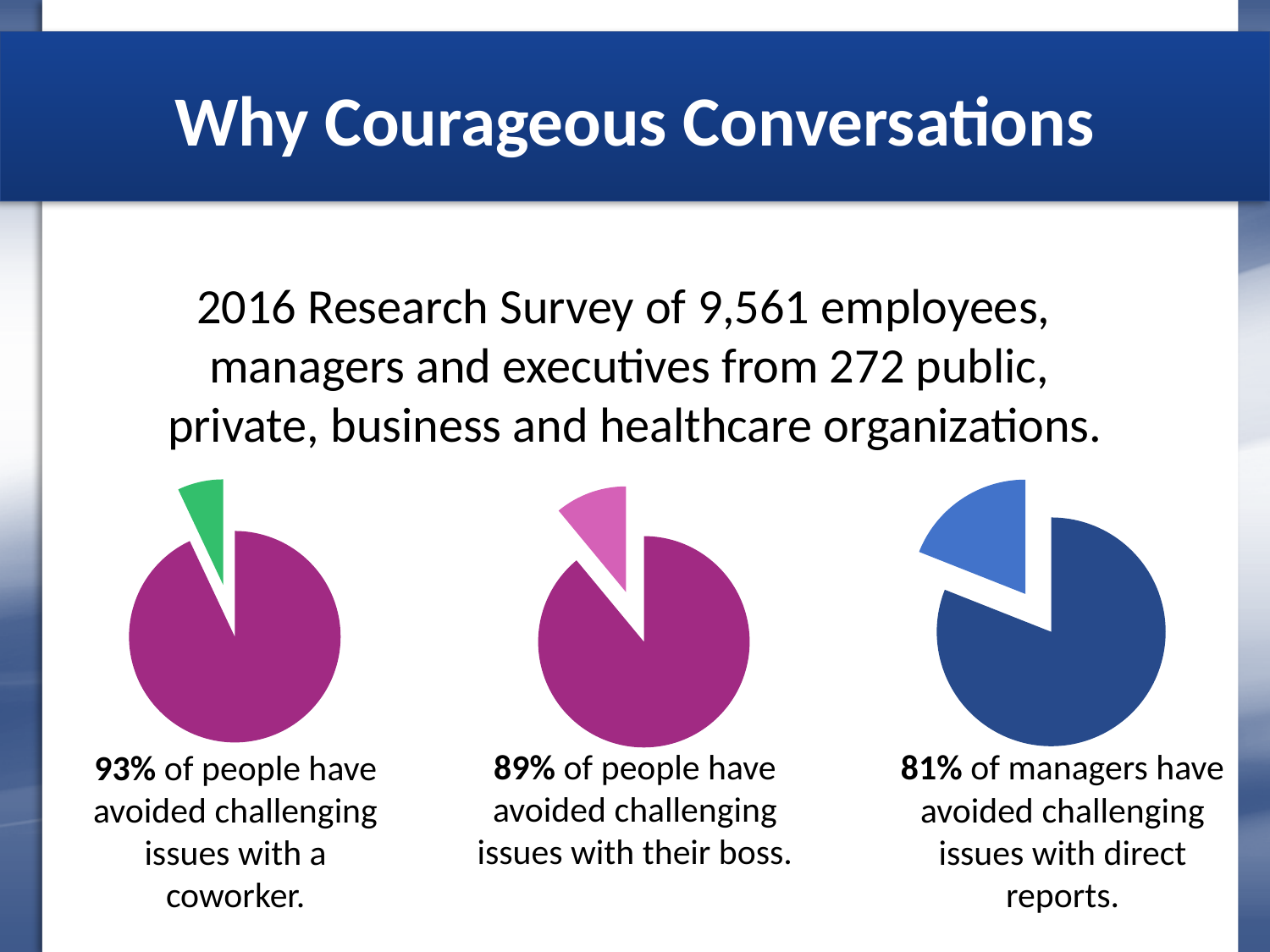
How many pie charts are on the slide? 3 Which of the three pie charts shows the largest share of people avoiding challenging issues? The left chart (coworker), 93% In the left pie chart, what share of people have avoided challenging issues with a coworker? 93% In the middle pie chart, what share of people have avoided challenging issues with their boss? 89% What is the difference between the share avoiding issues with a coworker and the share avoiding issues with their boss? 4% In the right pie chart, what share of managers have avoided challenging issues with direct reports? 81% What is the difference between the share avoiding issues with a coworker and the share of managers avoiding issues with direct reports? 12% Is the share of people avoiding challenging issues with their boss larger or smaller than the share of managers avoiding issues with direct reports? Larger How many slices does each pie chart have? 2 What colour is the small slice in the left pie chart? Green What kind of charts are shown on the slide? Pie charts Which of the three pie charts shows the smallest share of people avoiding challenging issues? The right chart (direct reports), 81%